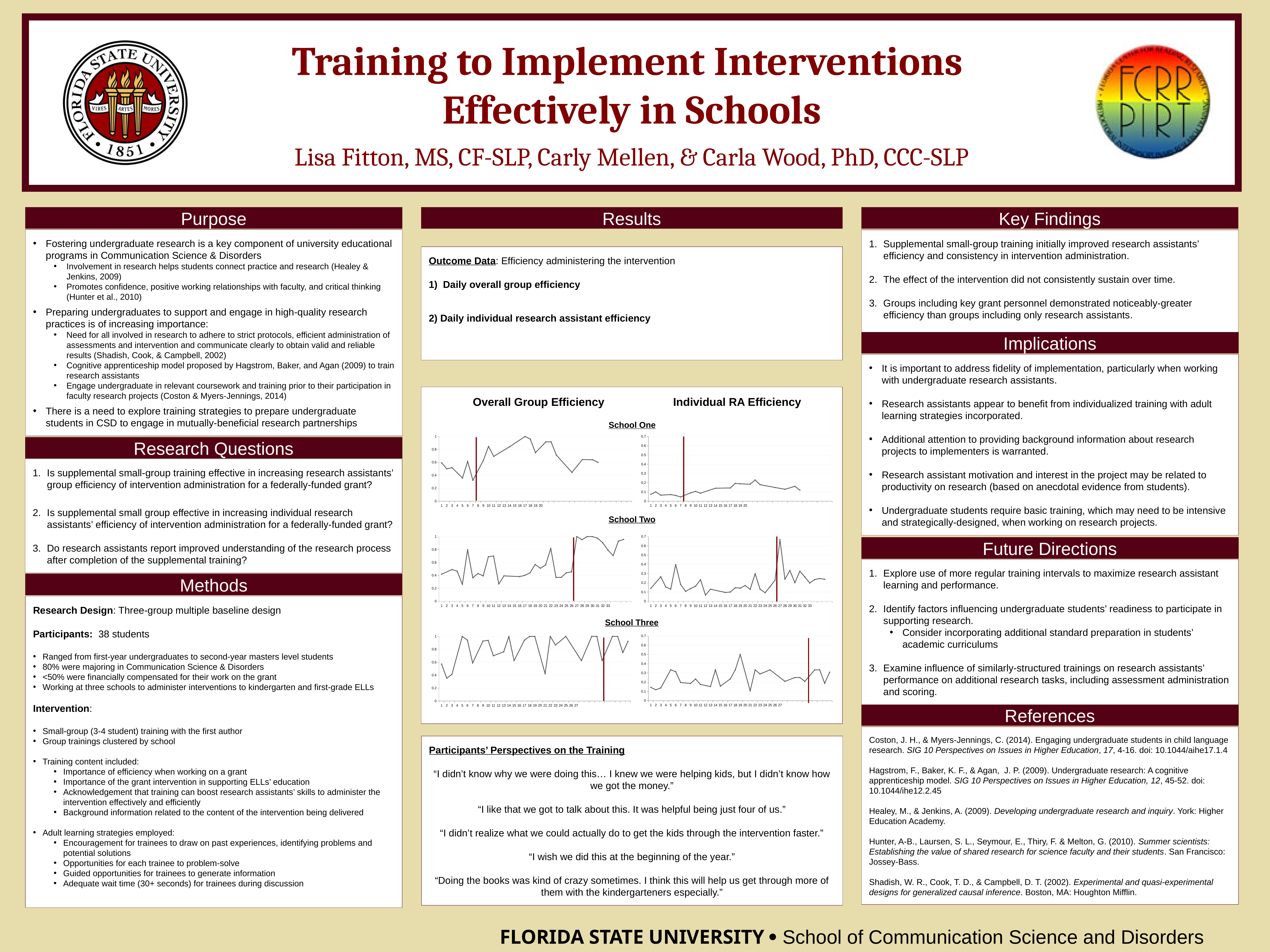
What is the highest value shown on the y axis of the Individual RA Efficiency charts? 0.7 What kind of chart is used for the School One Overall Group Efficiency data? line chart What are the two column headings above the charts in the Results section? Overall Group Efficiency and Individual RA Efficiency In the School One Overall Group Efficiency chart, is the value at point 17 greater or less than 0.8? greater In the School Two Overall Group Efficiency chart, is the value at point 1 greater or less than 0.6? less In the School Two Individual RA Efficiency chart, is the value at point 27 greater or less than 0.5? greater